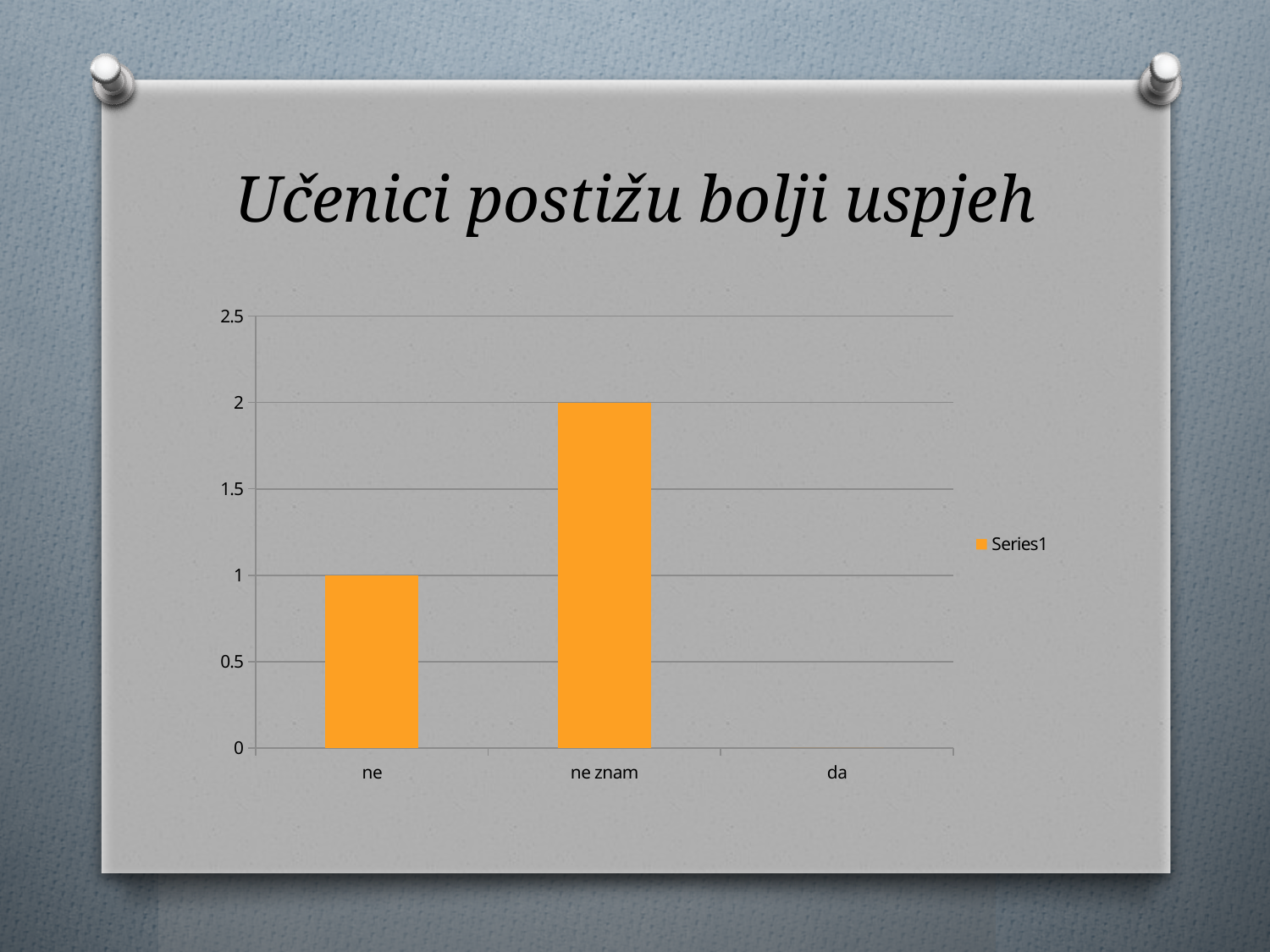
What is the value for "ne znam"? 2 What is the value for "ne"? 1 Is the value for "ne znam" greater or less than 1.5? greater What type of chart is shown on the slide? bar chart Which category has the highest value? ne znam Which is larger, the value for "ne" or the value for "ne znam"? ne znam Is the value for "ne" greater or less than 1.5? less Which category has the lowest value? da How many series does the legend list? 1 What is the title of the slide? Učenici postižu bolji uspjeh How many categories are shown on the x axis? 3 What is the difference between the values for "ne znam" and "ne"? 1